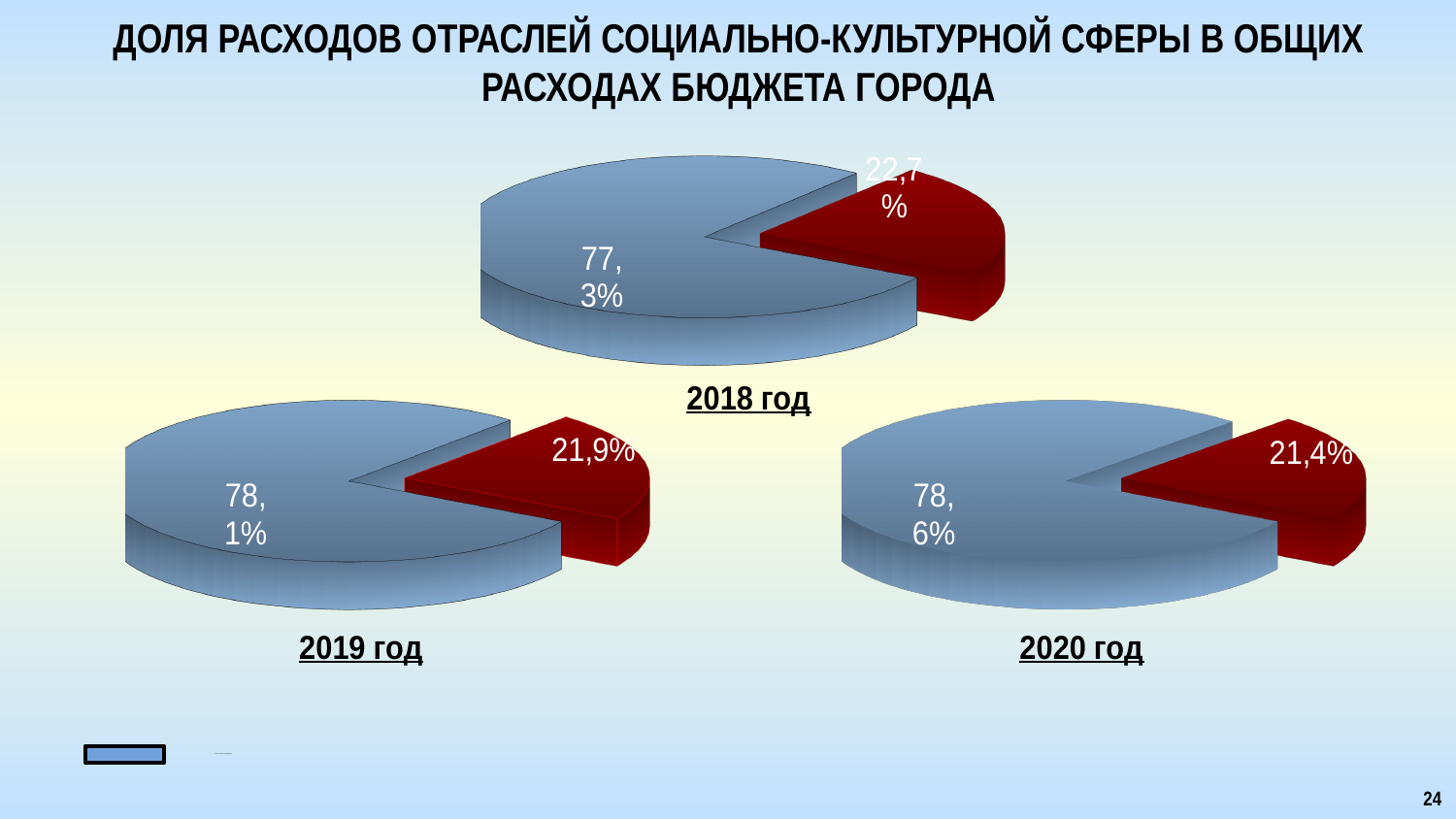
How many slices does each pie chart have? 2 Across the three pie charts, in which year is the red slice the smallest? 2020 год In the 2020 год pie chart, what value is shown for the blue slice? 78,6% Across the three pie charts, in which year is the red slice the largest? 2018 год In the 2018 год pie chart, what value is shown for the blue slice? 77,3% Does the red slice's share rise or fall from 2018 год to 2020 год? fall In the 2019 год pie chart, what value is shown for the red slice? 21,9% In the 2020 год pie chart, what value is shown for the red slice? 21,4% How many pie charts are on the slide? 3 In the 2019 год pie chart, what value is shown for the blue slice? 78,1% In the 2018 год pie chart, what value is shown for the red slice? 22,7% What type of charts are shown on the slide? pie charts